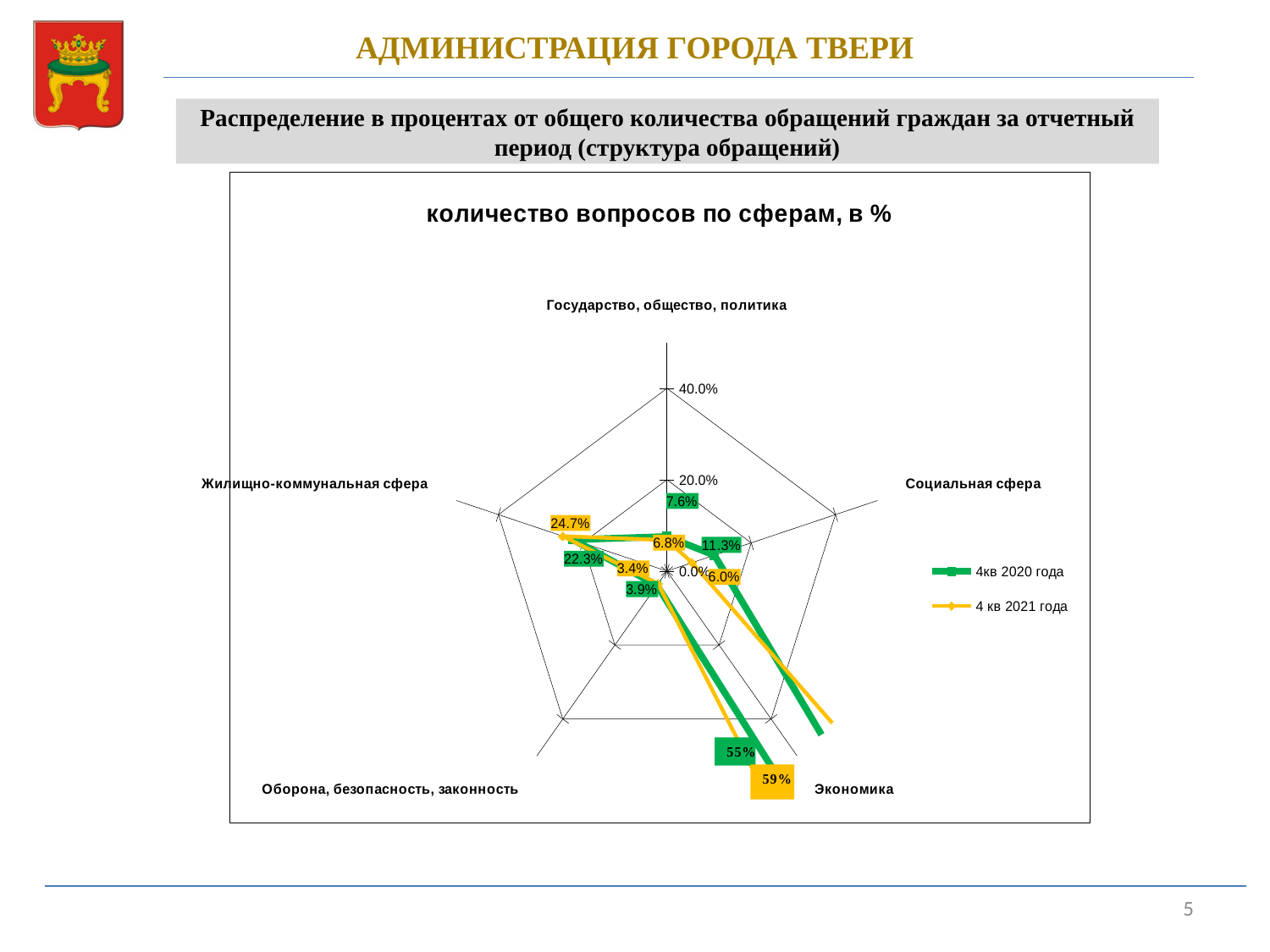
What is the difference between the 4кв 2020 года and 4 кв 2021 года values for Социальная сфера? 5.3% Which category has the highest value in the 4 кв 2021 года series? Экономика How many categories (axes) does the radar chart have? 5 Which series has the larger value for Оборона, безопасность, законность? 4кв 2020 года What is the value for Жилищно-коммунальная сфера in the 4 кв 2021 года series? 24.7% How many series does the legend list? 2 What is the value for Социальная сфера in the 4кв 2020 года series? 11.3% What is the value for Экономика in the 4 кв 2021 года series? 59% What is the value for Государство, общество, политика in the 4 кв 2021 года series? 6.8% What is the value for Экономика in the 4кв 2020 года series? 55% What kind of chart is shown on the slide? Radar chart Which category has the lowest value in the 4кв 2020 года series? Оборона, безопасность, законность